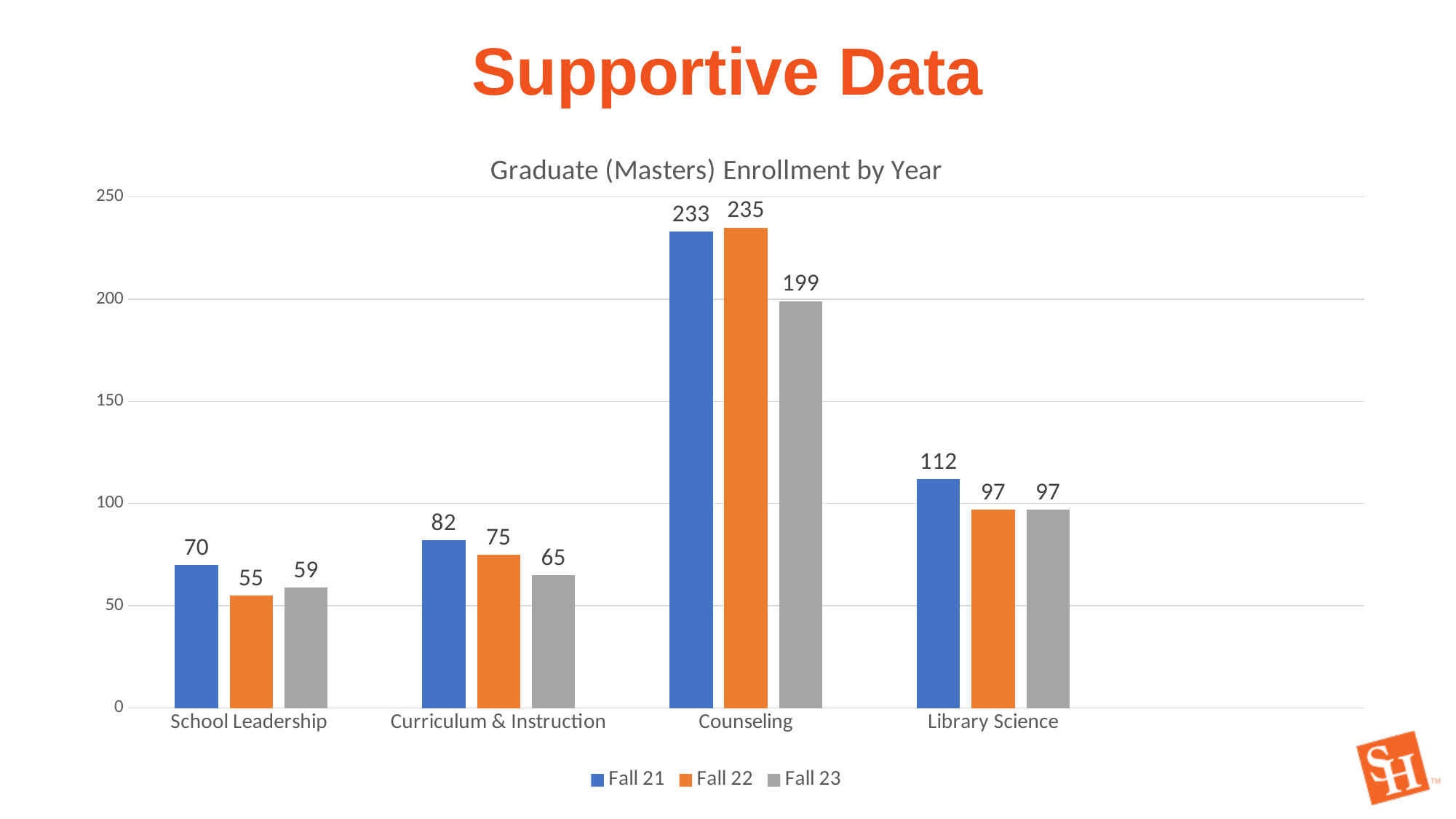
What is the difference between the Fall 21 and Fall 22 enrollment for Library Science? 15 What kind of chart is shown on the slide? Bar chart What is the title of the chart? Graduate (Masters) Enrollment by Year What is the Fall 22 enrollment for Library Science? 97 What is the difference between the Fall 22 and Fall 23 enrollment for Counseling? 36 What is the Fall 23 enrollment for School Leadership? 59 Which program has the highest Fall 22 enrollment? Counseling Which program has the lowest Fall 21 enrollment? School Leadership Which is larger for Curriculum & Instruction: the Fall 21 or the Fall 23 enrollment? Fall 21 How many programs are shown on the x axis? 4 How many series does the legend list? 3 What is the Fall 21 enrollment for Counseling? 233